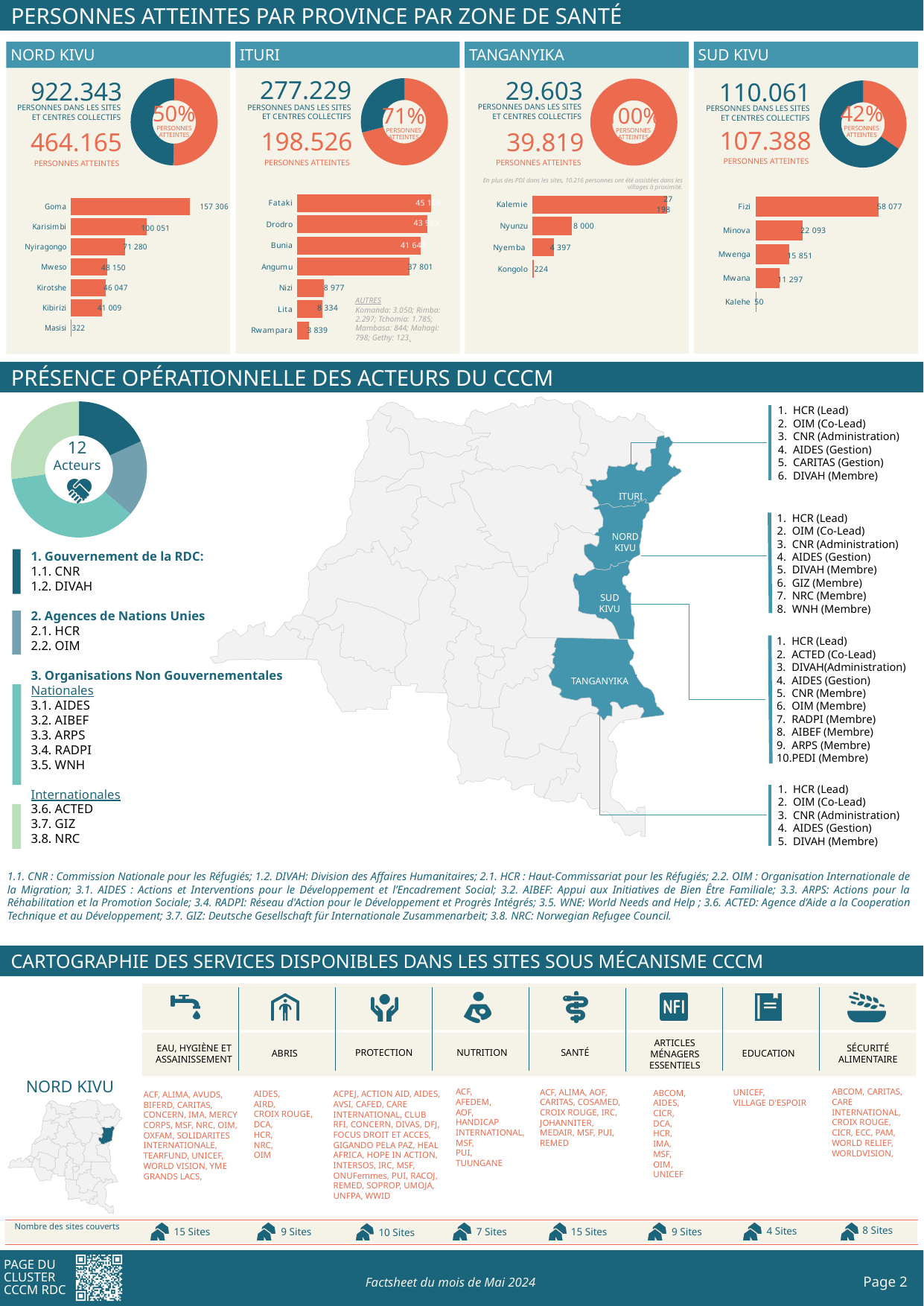
In the Nord Kivu bar chart, what is the value for Goma? 157 306 In the Sud Kivu bar chart, which health zone has the highest value? Fizi In the Nord Kivu bar chart, what is the difference between the values for Goma and Karisimbi? 57 255 What type of chart is used to show the values per health zone in the Sud Kivu panel? Bar chart In the Ituri bar chart, which health zone has the lowest value? Rwampara In the Tanganyika bar chart, what is the value for Nyunzu? 8 000 In the Sud Kivu bar chart, which is larger, the value for Mwenga or the value for Mwana? Mwenga In the Nord Kivu bar chart, which health zone has the highest value? Goma In the Ituri bar chart, what is the value for Angumu? 37 801 In the Tanganyika bar chart, how many health zones are shown? 4 In the Nord Kivu bar chart, which health zone has the lowest value? Masisi In the Nord Kivu bar chart, how many health zones are shown? 7